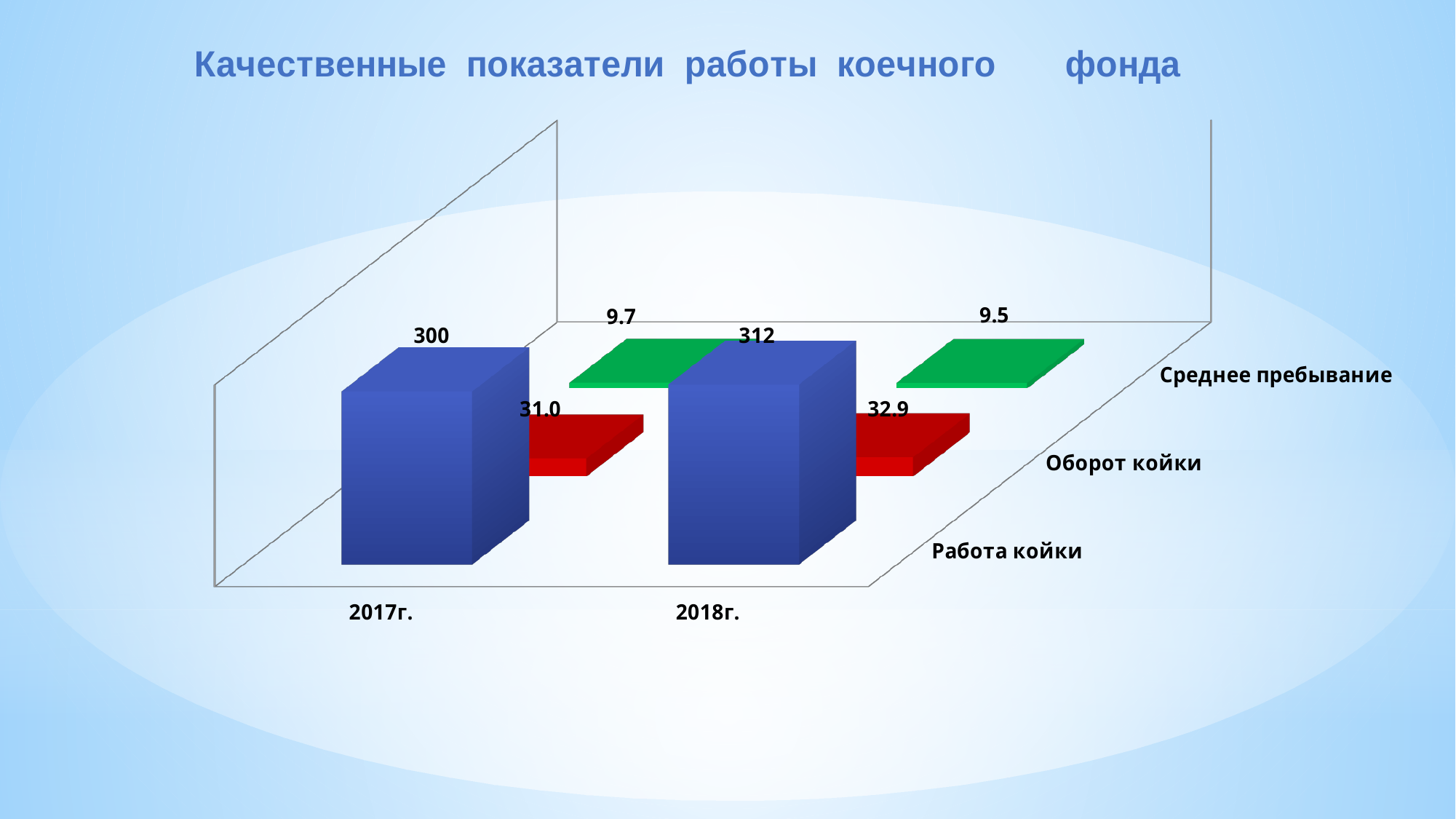
What is the value of Среднее пребывание for 2018г.? 9.5 What is the value of Работа койки for 2017г.? 300 By how much did Работа койки increase from 2017г. to 2018г.? 12 How many series are plotted in the chart? 3 What is the value of Среднее пребывание for 2017г.? 9.7 What is the difference in Оборот койки between 2018г. and 2017г.? 1.9 What is the value of Оборот койки for 2017г.? 31.0 Which year has the higher Среднее пребывание, 2017г. or 2018г.? 2017г. Does Работа койки rise or fall from 2017г. to 2018г.? rise What is the value of Работа койки for 2018г.? 312 What type of chart is shown on the slide? bar chart What is the value of Оборот койки for 2018г.? 32.9